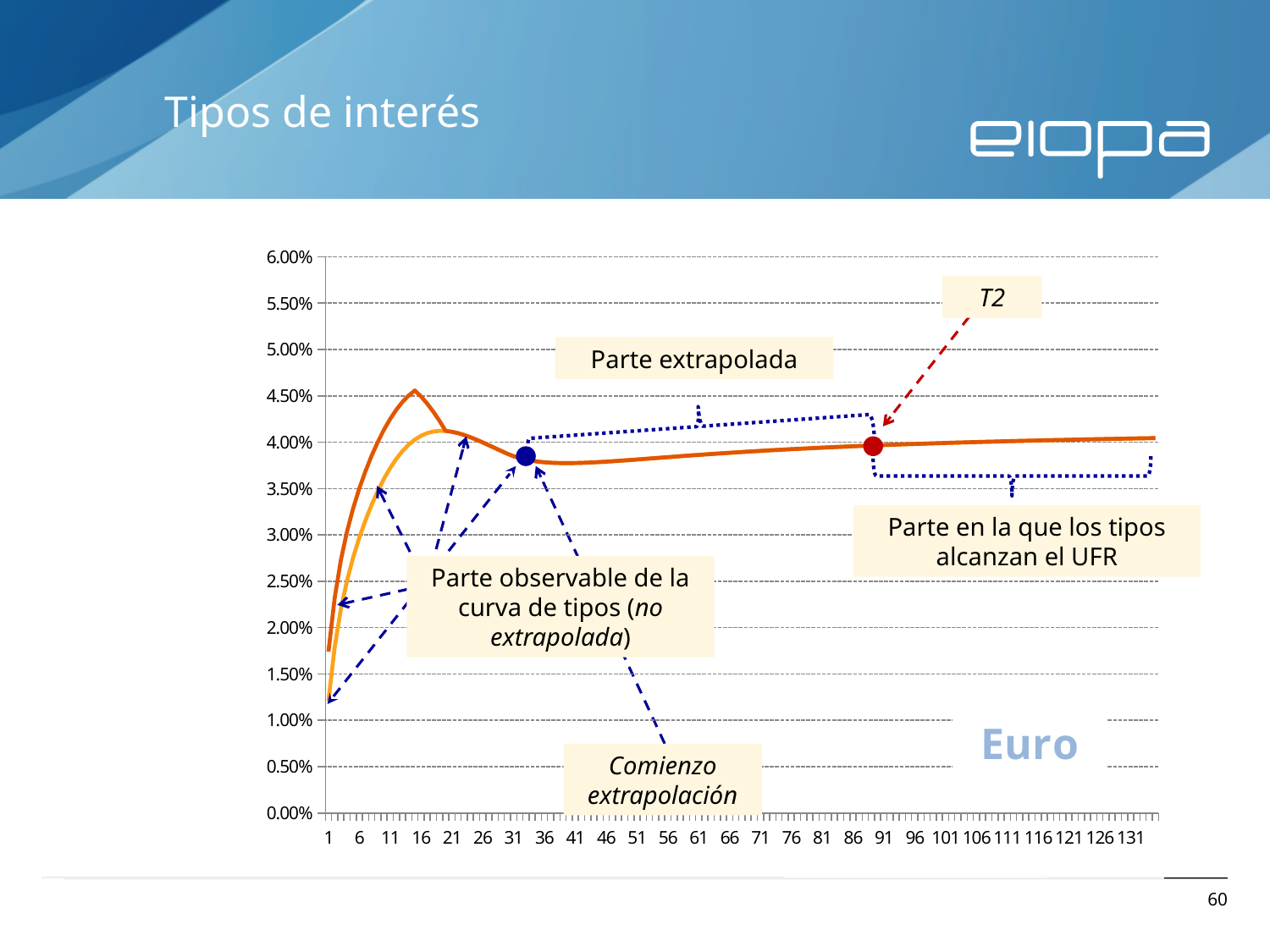
Does the curve rise or fall between x = 16 and x = 36? fall What is the highest value shown on the vertical axis? 6.00% Is the value of the lighter (yellow-orange) line at x = 1 greater or less than 1.50%? less Is the peak value of the darker (red-orange) line greater or less than 4.00%? greater Does the darker (red-orange) line rise or fall between x = 1 and x = 16? rise What is the title of the slide containing the chart? Tipos de interés How many lines (curves) are plotted on the chart? 2 Is the value of the darker (red-orange) line at x = 1 greater or less than 2.00%? less What kind of chart is shown on the slide? line chart What is the last label shown on the horizontal axis? 131